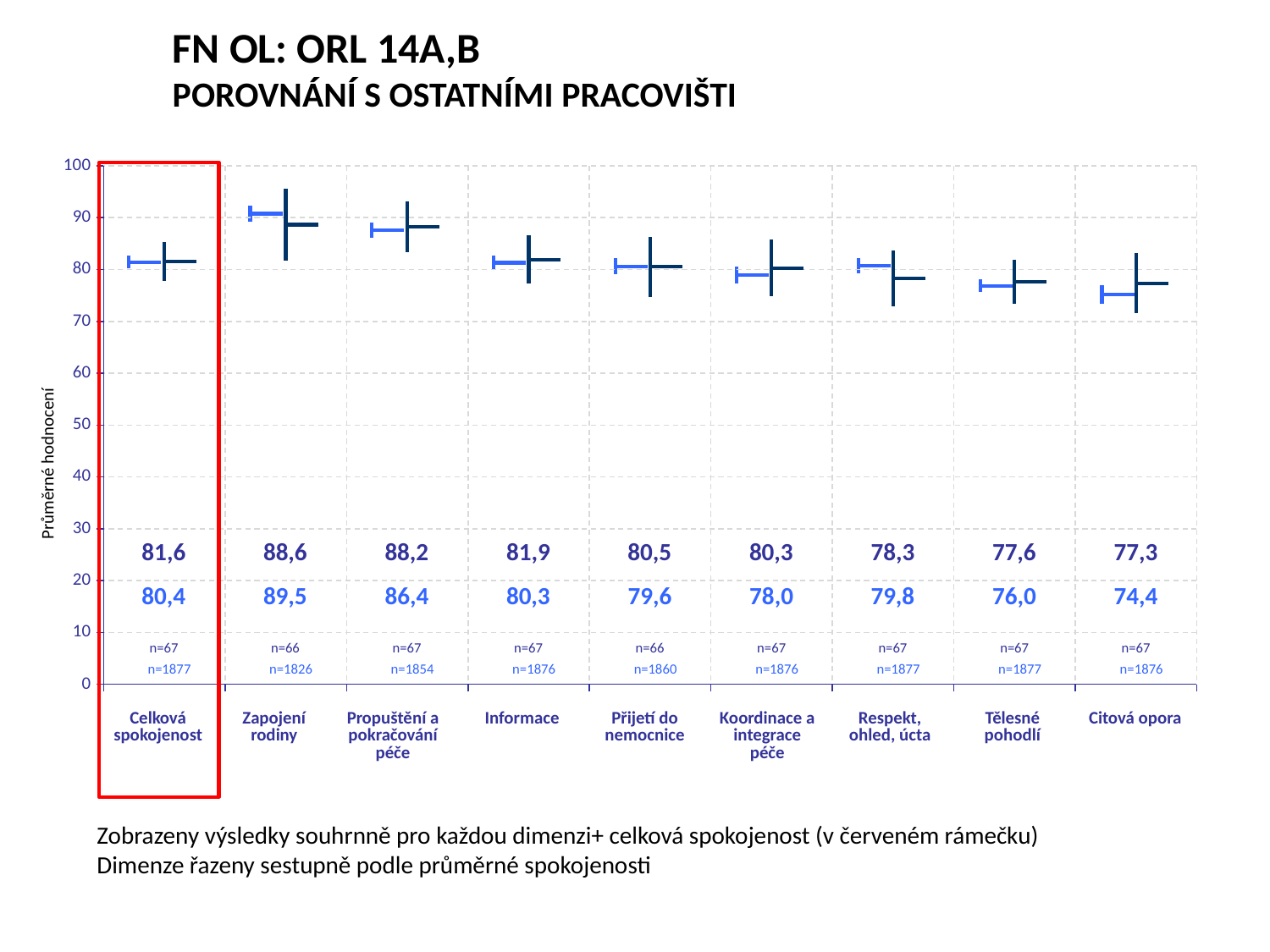
What is the sample size n printed in dark blue for Zapojení rodiny? n=66 Which category is highlighted with a red frame? Celková spokojenost What is the light blue (lower) value shown for Celková spokojenost? 80,4 How many dimensions (categories) are shown along the x axis? 9 Which dimension has the highest dark blue (upper) value? Zapojení rodiny What is the dark blue (upper) value shown for Zapojení rodiny? 88,6 What is the dark blue (upper) value shown for Celková spokojenost? 81,6 What is the light blue (lower) value shown for Citová opora? 74,4 What is the difference between the dark blue and light blue values for Propuštění a pokračování péče? 1,8 Which dimension has the lowest light blue (lower) value? Citová opora For Respekt, ohled, úcta, which is larger: the dark blue value or the light blue value? the light blue value (79,8) What is the label of the y axis? Průměrné hodnocení